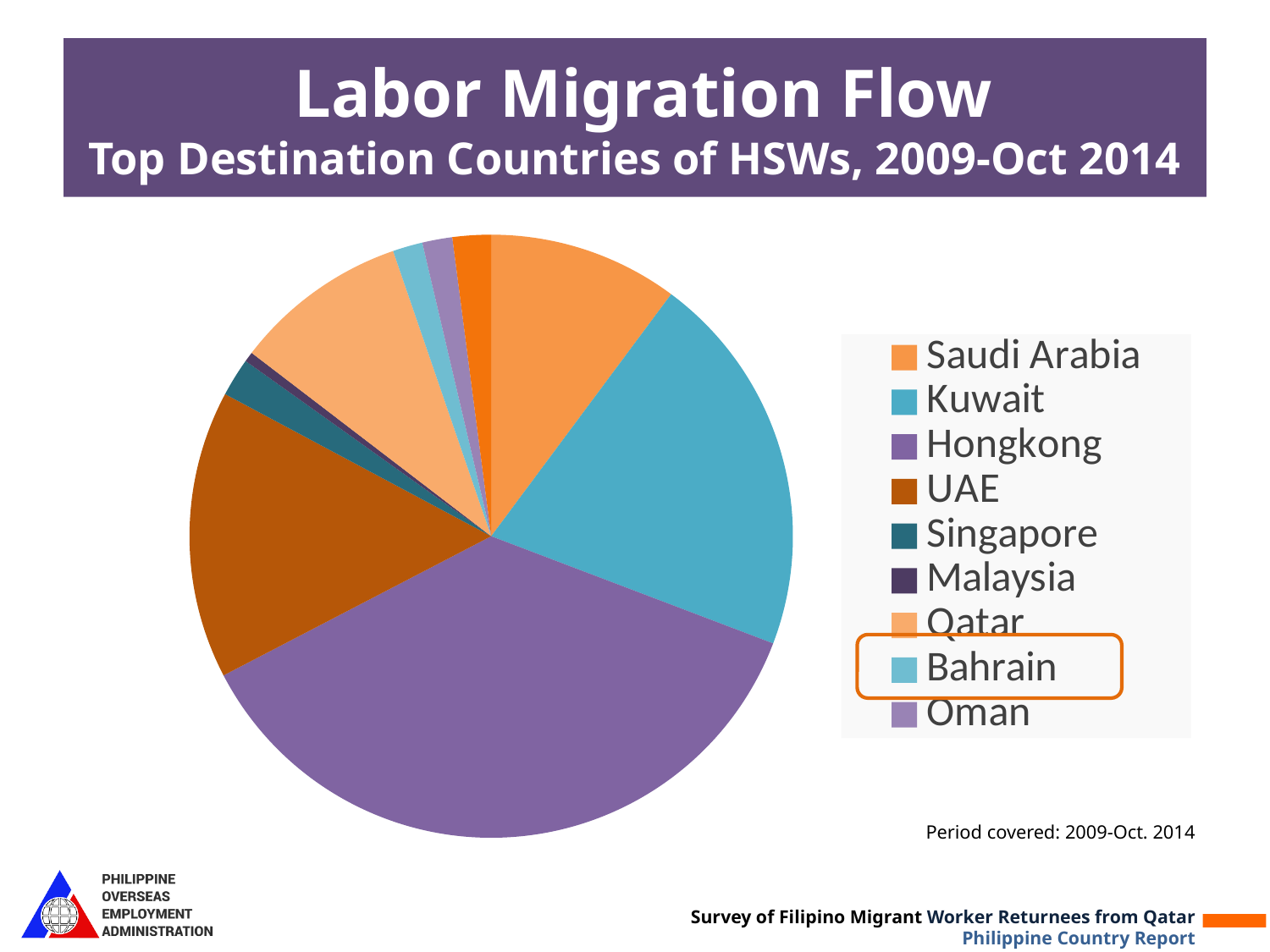
Which slice is larger, UAE or Qatar? UAE How many destination countries are listed in the legend? 9 What is the subtitle of the chart shown on the slide? Top Destination Countries of HSWs, 2009-Oct 2014 Which slice is larger, Kuwait or Saudi Arabia? Kuwait Which slice is larger, Hongkong or Kuwait? Hongkong Which legend entry is highlighted with an orange outline? Bahrain Which destination country has the largest slice of the pie? Hongkong What kind of chart is shown on the slide? pie chart